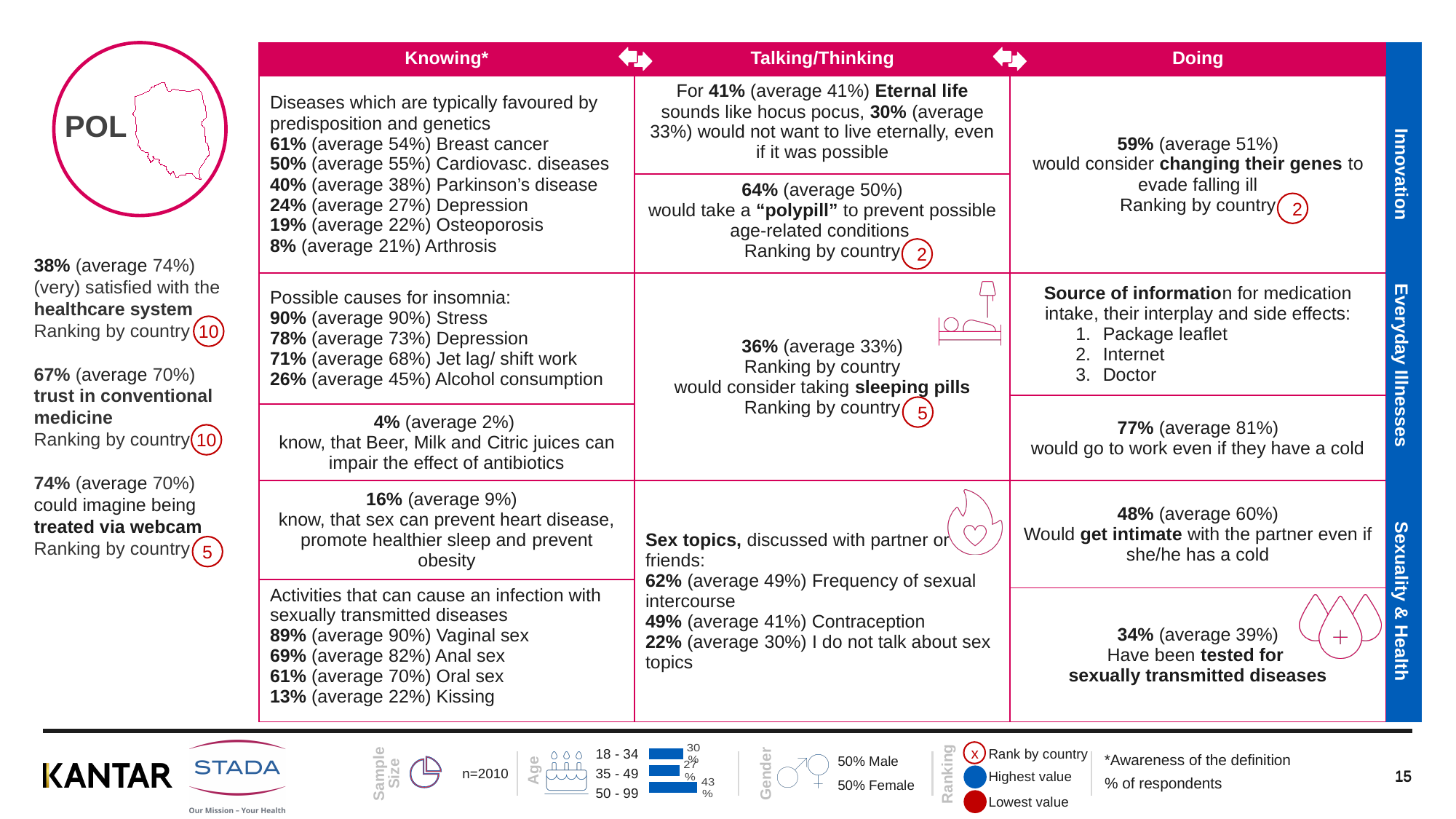
In the Age bar chart at the bottom of the slide, what is the value for the 18 - 34 age group? 30% What is the sample size (n) shown next to the Age bar chart at the bottom of the slide? n=2010 In the Age bar chart at the bottom of the slide, what is the value for the 50 - 99 age group? 43% In the Age bar chart at the bottom of the slide, what is the difference between the 18 - 34 value and the 35 - 49 value? 3% In the Age bar chart at the bottom of the slide, which age group has the highest value? 50 - 99 In the Age bar chart at the bottom of the slide, what is the value for the 35 - 49 age group? 27% In the Age bar chart at the bottom of the slide, which is larger: the value for 18 - 34 or for 35 - 49? 18 - 34 In the Age bar chart at the bottom of the slide, what is the difference between the 50 - 99 value and the 18 - 34 value? 13% How many age groups are shown in the Age bar chart at the bottom of the slide? 3 What kind of chart is the Age chart at the bottom of the slide? bar chart In the Age bar chart at the bottom of the slide, which age group has the lowest value? 35 - 49